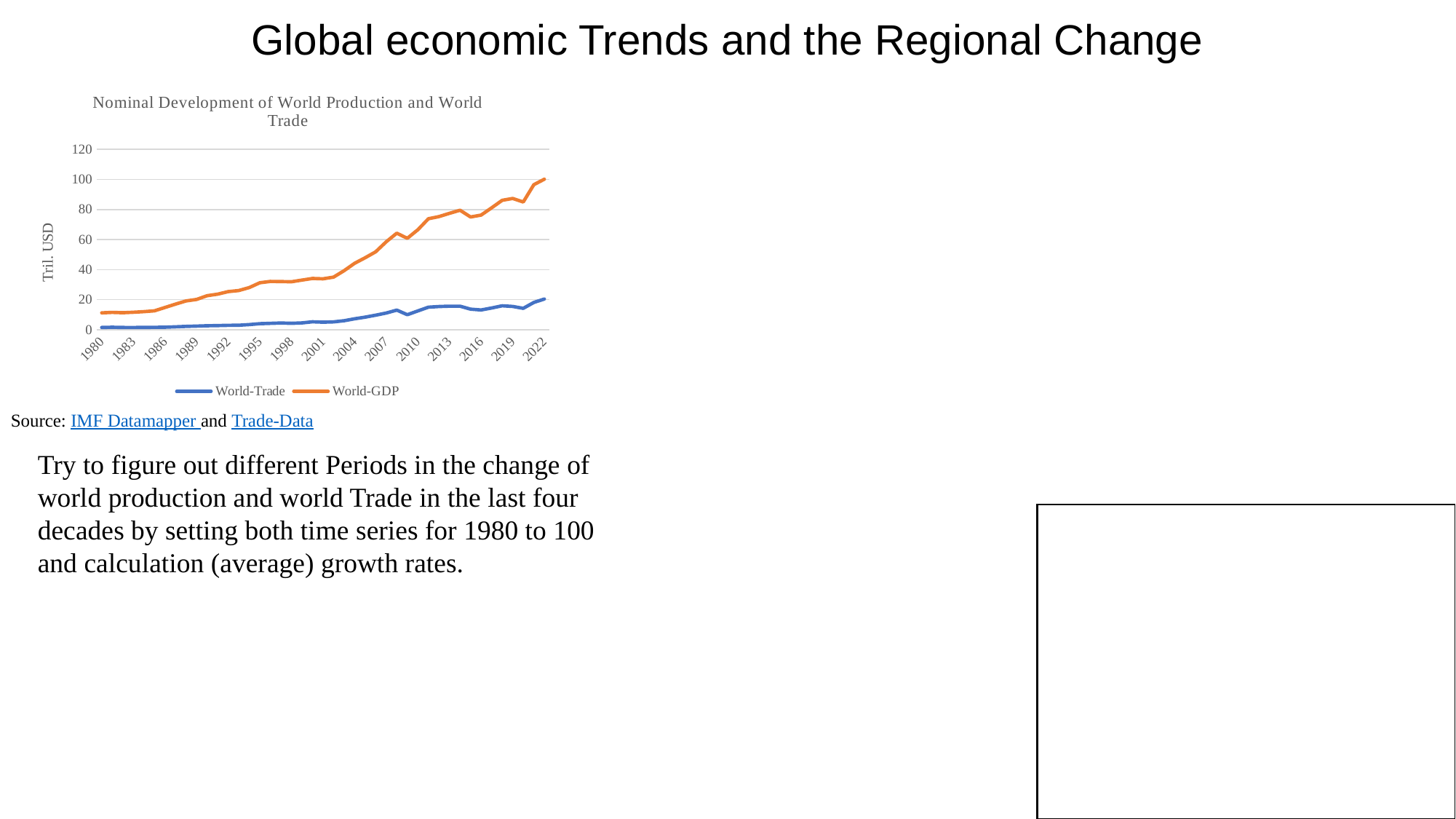
Does the World-Trade line generally rise or fall from 1980 to 2022? rise What is the label on the vertical axis of the chart? Tril. USD Is the value for World-Trade in 2022 greater or less than 40? less Is the value for World-GDP in 2013 greater or less than 60? greater Does the World-GDP line generally rise or fall from 1980 to 2022? rise In 2022, which series has the larger value, World-Trade or World-GDP? World-GDP What kind of chart is shown on the slide? line chart In which year does the World-GDP series reach its highest value? 2022 Is the value for World-GDP in 2022 greater or less than 80? greater How many series does the legend of the chart list? 2 What is the title of the chart? Nominal Development of World Production and World Trade